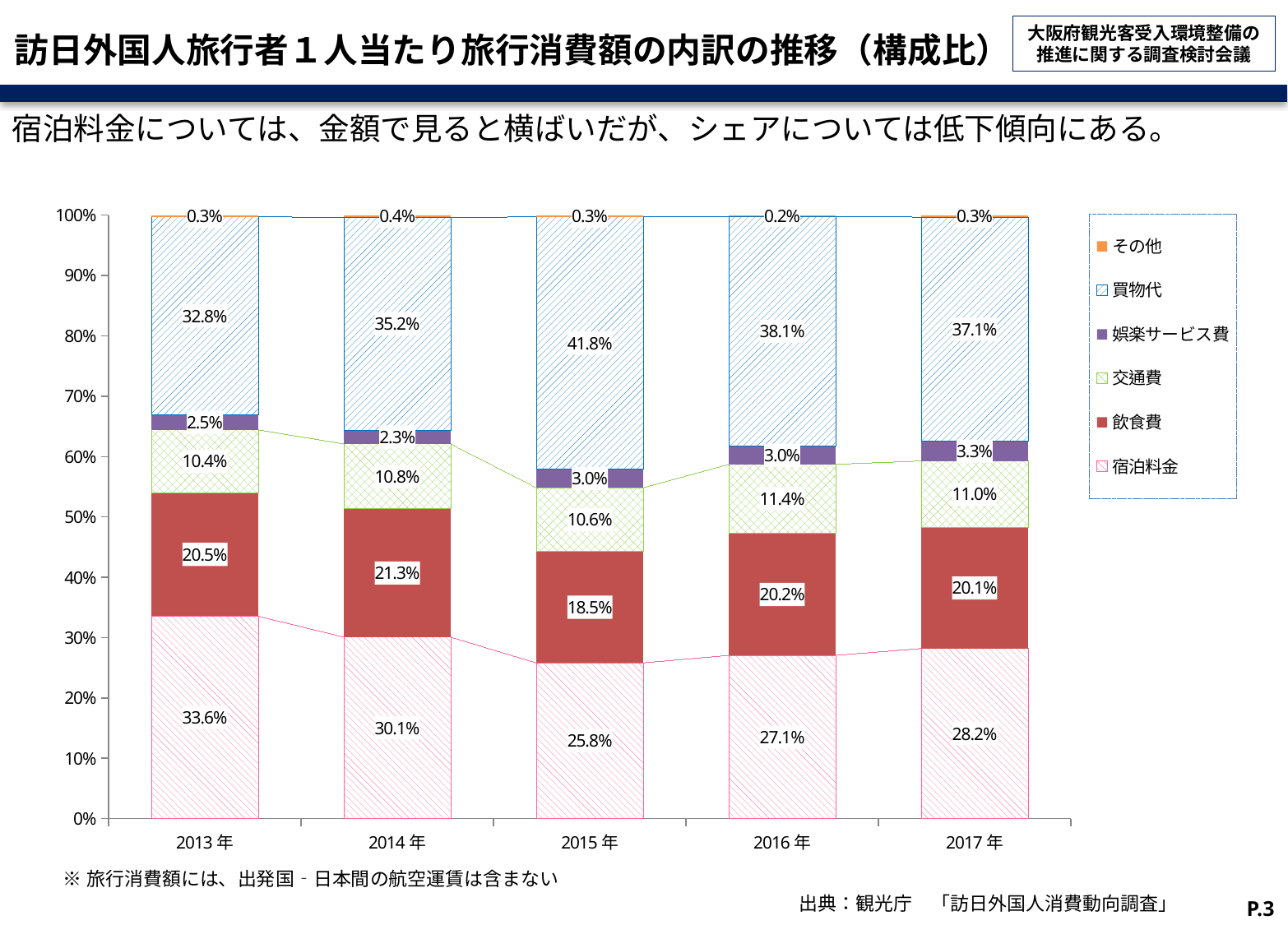
What kind of chart is shown on the slide? Stacked bar chart Which legend entry is shown in purple? 娯楽サービス費 What is the value for 買物代 in 2015 年? 41.8% Which is larger in 2014 年, the share of 宿泊料金 or the share of 買物代? 買物代 How many years are shown on the x axis? 5 What is the difference between the 宿泊料金 share in 2013 年 and in 2017 年? 5.4% How many series does the legend list? 6 In which year is the share of 買物代 the highest? 2015 年 What share does 宿泊料金 account for in 2013 年? 33.6% In which year is the share of 宿泊料金 the lowest? 2015 年 What is the value for 飲食費 in 2017 年? 20.1% Does the share of 宿泊料金 rise or fall from 2013 年 to 2015 年? Fall